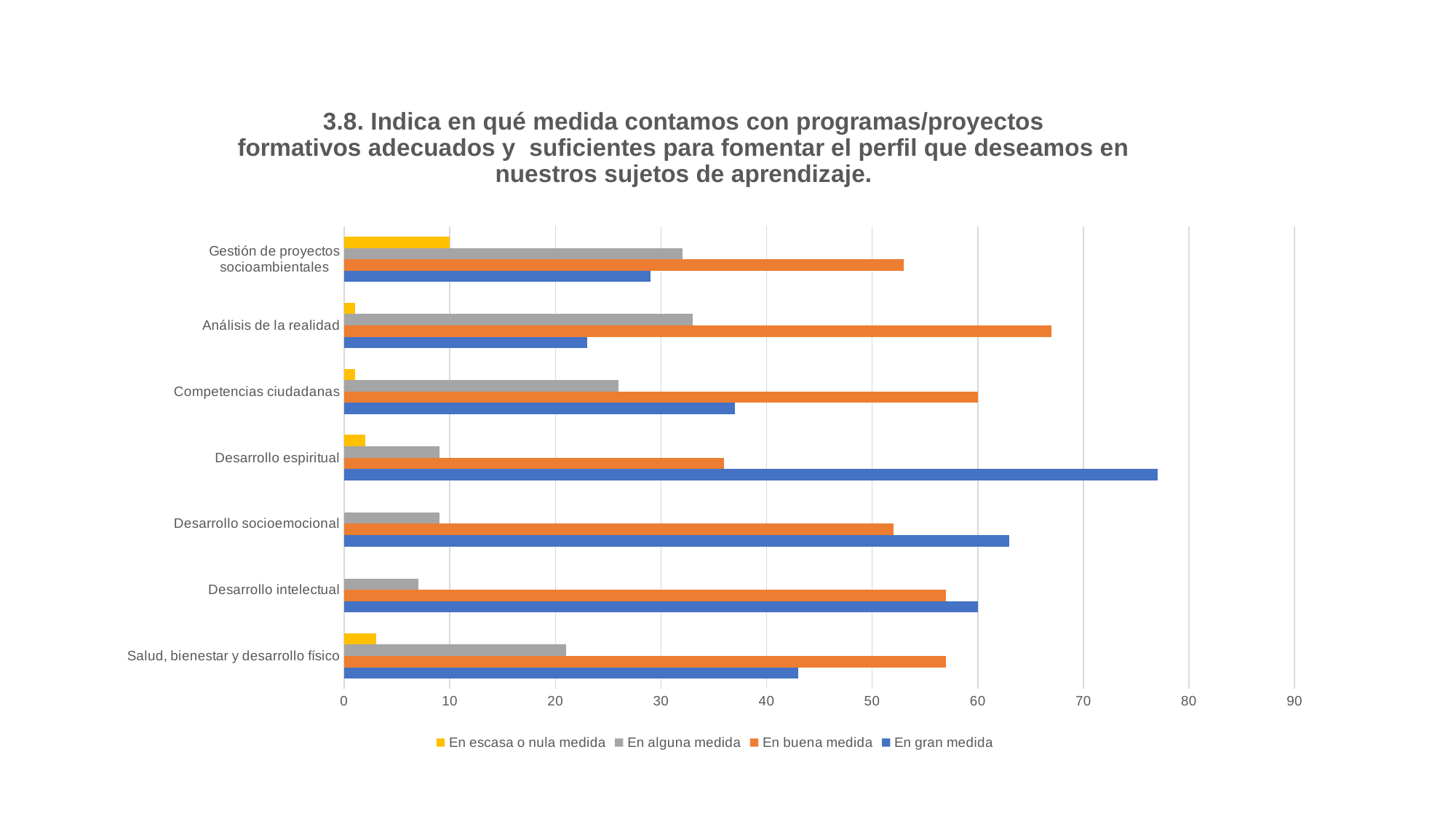
How many categories are shown on the vertical axis of the chart? 7 Is the value for 'En gran medida' in 'Desarrollo espiritual' greater or less than 70? greater Which category has the highest value for 'En gran medida'? Desarrollo espiritual Which category has the lowest value for 'En gran medida'? Análisis de la realidad For 'Desarrollo espiritual', which is larger: 'En gran medida' or 'En buena medida'? En gran medida Which colour represents the 'En gran medida' series in the legend? blue Is the value for 'En gran medida' in 'Análisis de la realidad' greater or less than 30? less Is the value for 'En buena medida' in 'Análisis de la realidad' greater or less than 60? greater Which category has the highest value for 'En buena medida'? Análisis de la realidad How many series does the legend list? 4 What kind of chart is shown on the slide? bar chart For 'Análisis de la realidad', which is larger: 'En buena medida' or 'En alguna medida'? En buena medida